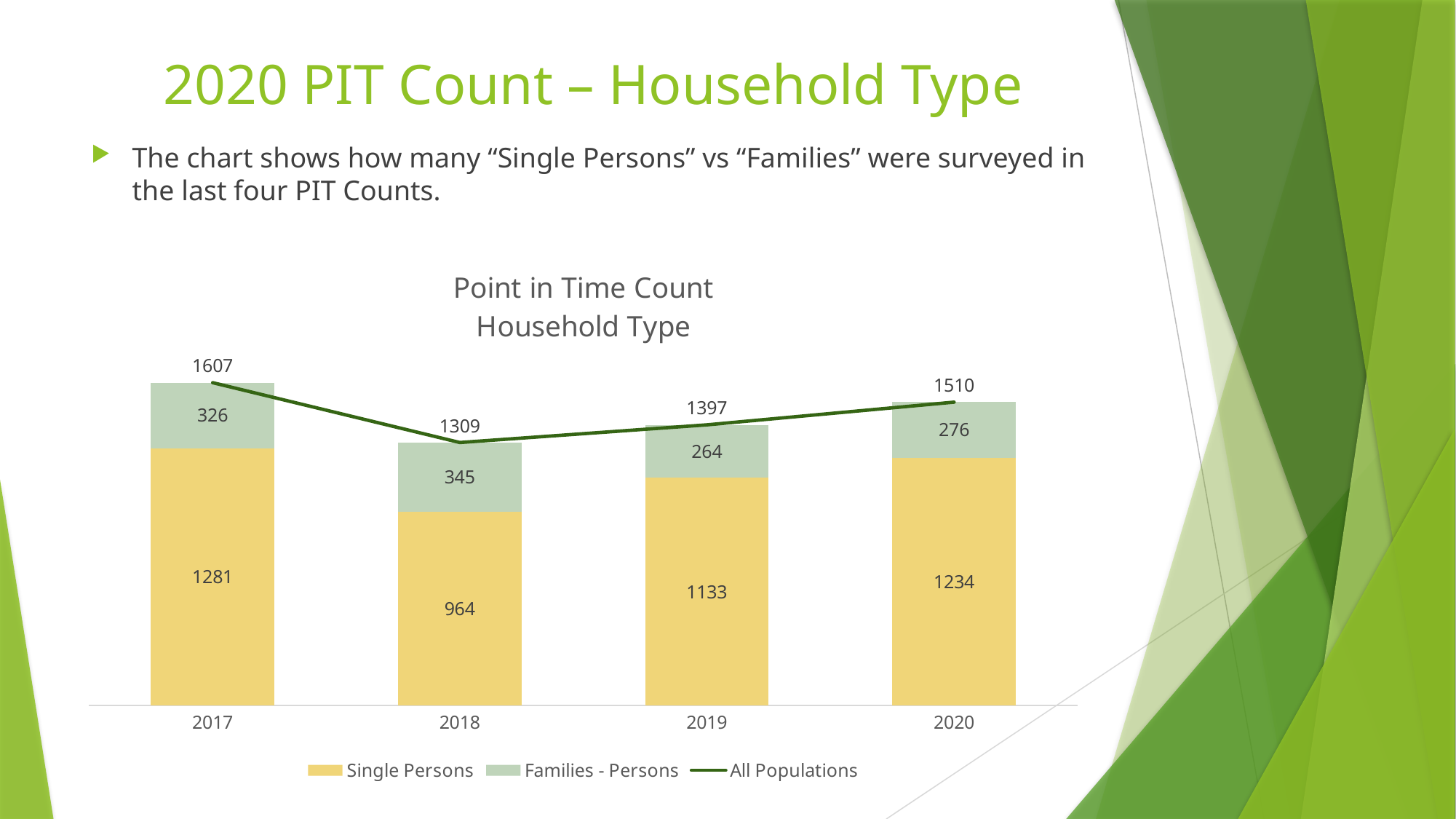
How many years are shown on the x axis? 4 What kind of chart is this? Stacked bar chart with a line What is the title of the chart? Point in Time Count Household Type What is the All Populations value for 2019? 1397 Does the All Populations line rise or fall from 2018 to 2020? Rise Which year has the lowest Single Persons value? 2018 Which is larger, the Families - Persons value for 2017 or for 2020? 2017 What is the value for Single Persons in 2017? 1281 How many series does the legend list? 3 Which year has the highest All Populations value? 2017 What is the difference between the Single Persons values for 2017 and 2018? 317 What is the value for Families - Persons in 2018? 345